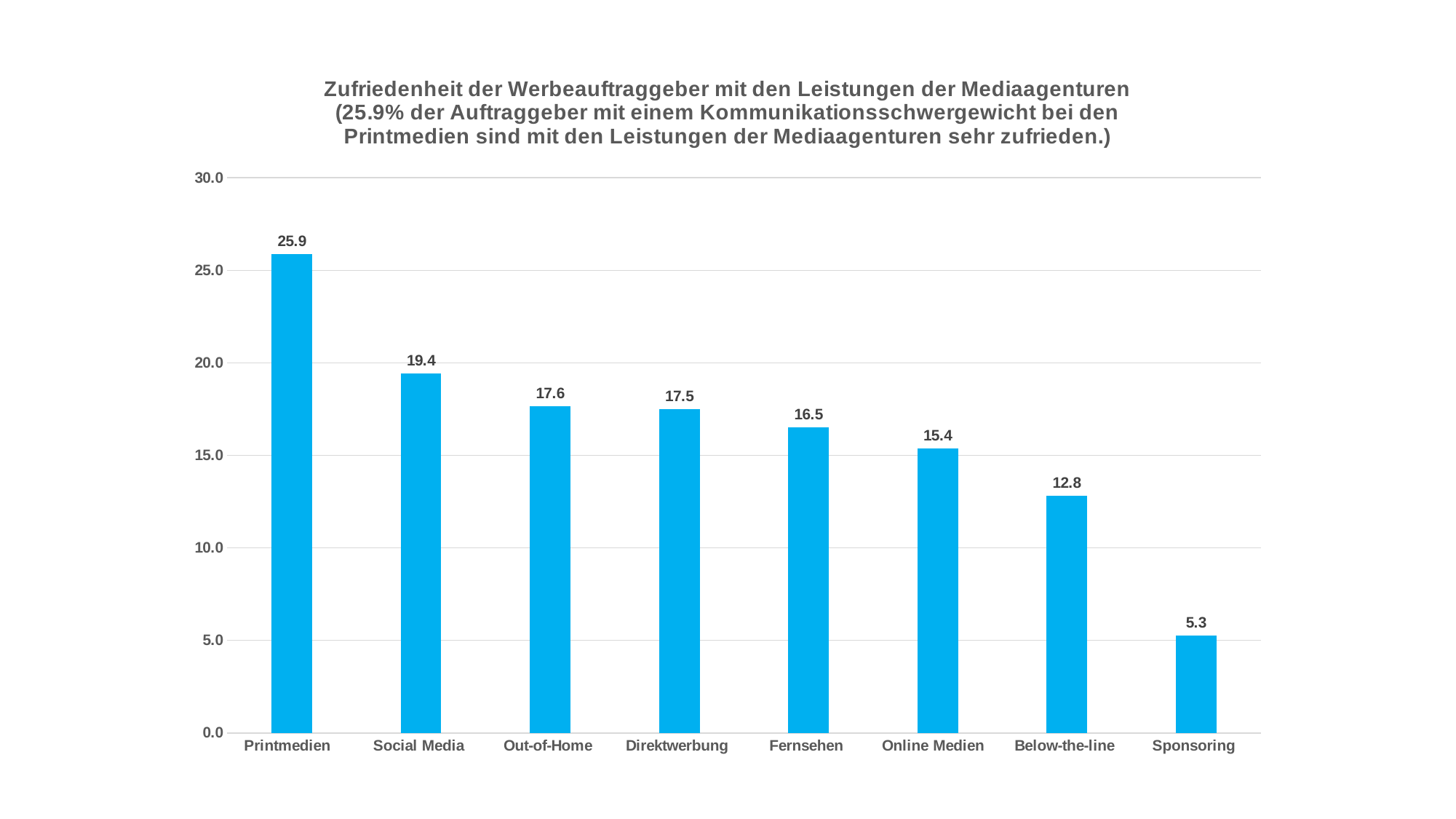
Which category has the highest value? Printmedien Which is larger, the value for Social Media or the value for Online Medien? Social Media What is the difference between the values for Below-the-line and Sponsoring? 7.5 What is the value for Printmedien? 25.9 How many categories are shown on the x axis? 8 What kind of chart is shown on the slide? bar chart Is the value for Below-the-line greater or less than 15.0? less What is the value for Sponsoring? 5.3 Which category has the lowest value? Sponsoring What is the difference between the values for Printmedien and Social Media? 6.5 Do the values rise or fall from left to right along the x axis? fall What is the value for Fernsehen? 16.5